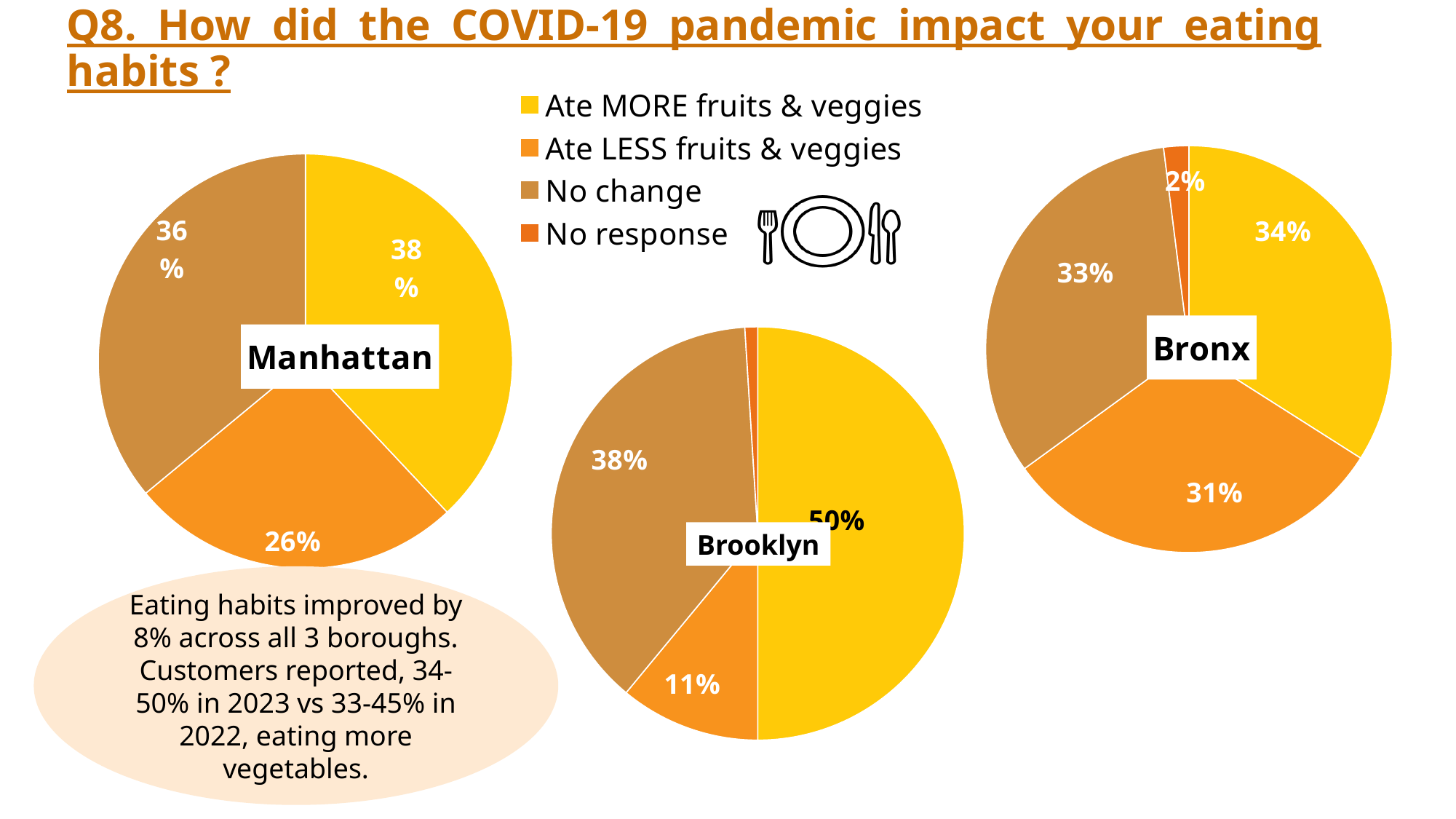
What kind of chart is used for each borough on this slide? Pie chart In the Brooklyn pie chart, what is the difference between the 'No change' share and the 'Ate LESS fruits & veggies' share? 27% In the Bronx pie chart, what share of respondents reported no change? 33% In the Brooklyn pie chart, what share of respondents said they ate LESS fruits & veggies? 11% Which borough's pie chart shows a larger share for 'Ate MORE fruits & veggies', Brooklyn or Bronx? Brooklyn In the Manhattan pie chart, what is the difference between the share that ate MORE fruits & veggies and the share that ate LESS fruits & veggies? 12% In the Bronx pie chart, which category has the smallest slice? No response In the Brooklyn pie chart, which category has the largest slice? Ate MORE fruits & veggies How many entries does the shared legend list? 4 In the Bronx pie chart, what share of respondents gave no response? 2% In the Manhattan pie chart, what share of respondents said they ate MORE fruits & veggies? 38% How many pie charts are shown on the slide? 3